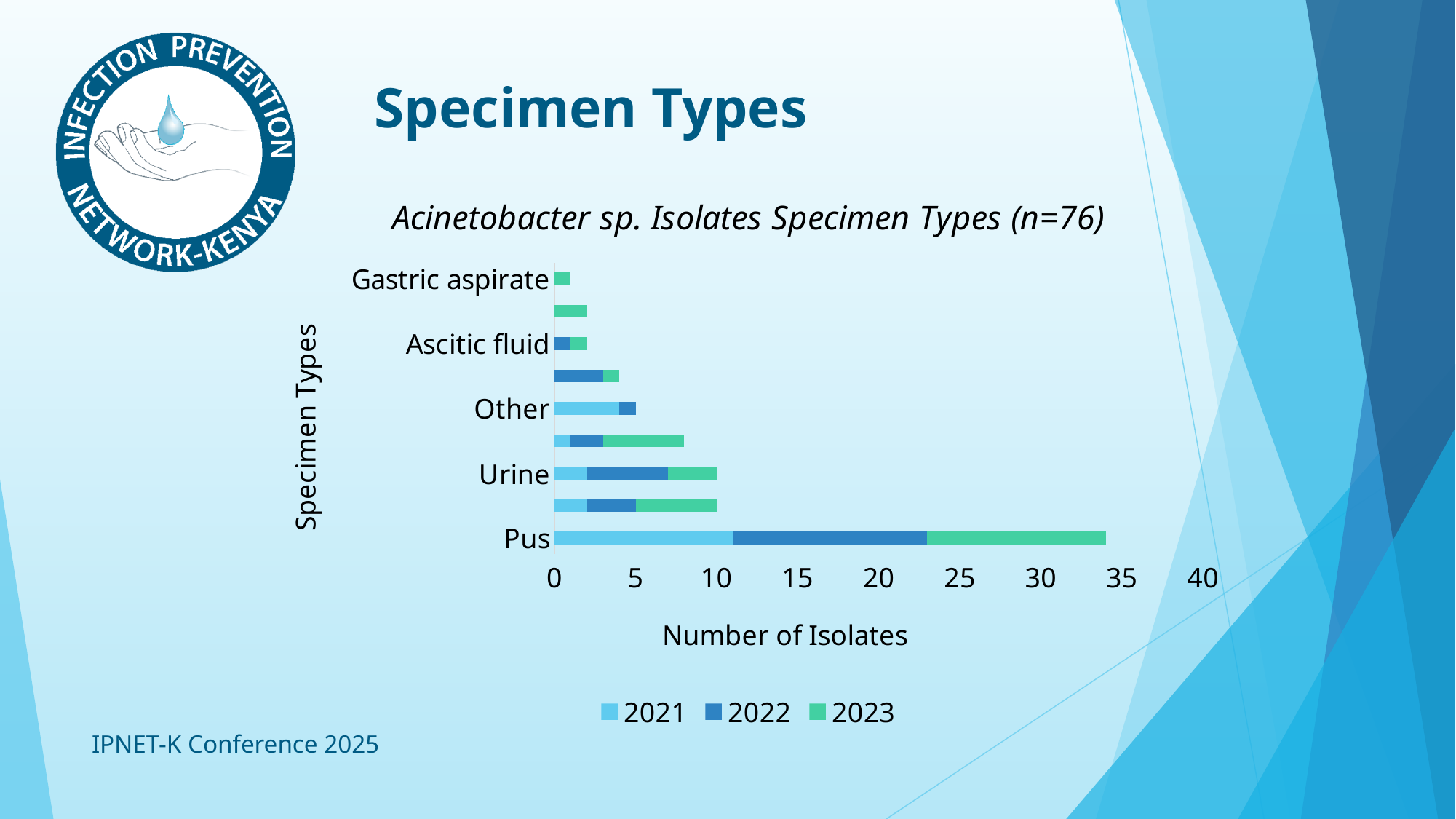
Is the total number of isolates for Pus greater or less than 30? greater Which has a smaller total number of isolates, Ascitic fluid or Pus? Ascitic fluid Which has a larger total number of isolates, Urine or Gastric aspirate? Urine Is the total number of isolates for Gastric aspirate greater or less than 5? less What are the series listed in the legend? 2021, 2022, 2023 What is the title of the chart? Acinetobacter sp. Isolates Specimen Types (n=76) Which specimen type has the highest total number of isolates? Pus Is the total number of isolates for Urine greater or less than 15? less What kind of chart is shown on the slide? Stacked bar chart Which has a larger total number of isolates, Pus or Urine? Pus How many series does the legend list? 3